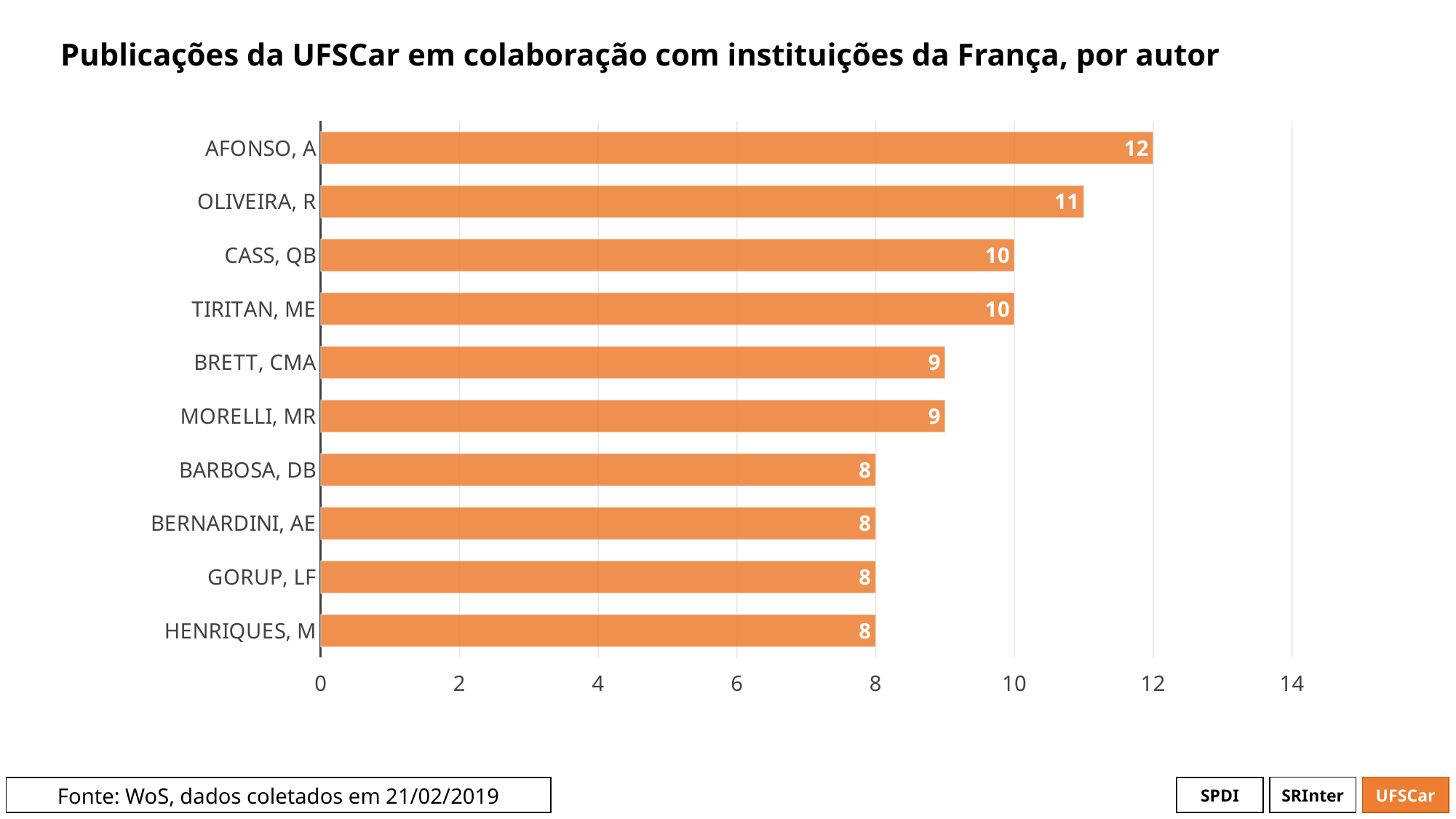
Which author has the highest value? AFONSO, A Which is larger, the value for TIRITAN, ME or the value for MORELLI, MR? TIRITAN, ME What is the value for BRETT, CMA? 9 What is the value for HENRIQUES, M? 8 What is the value for AFONSO, A? 12 How many authors are shown in the chart? 10 What is the highest tick value shown on the horizontal axis? 14 What is the difference between the values for CASS, QB and BARBOSA, DB? 2 What kind of chart is shown on the slide? Bar chart What is the difference between the values for AFONSO, A and OLIVEIRA, R? 1 What is the value for OLIVEIRA, R? 11 What is the title of the chart? Publicações da UFSCar em colaboração com instituições da França, por autor